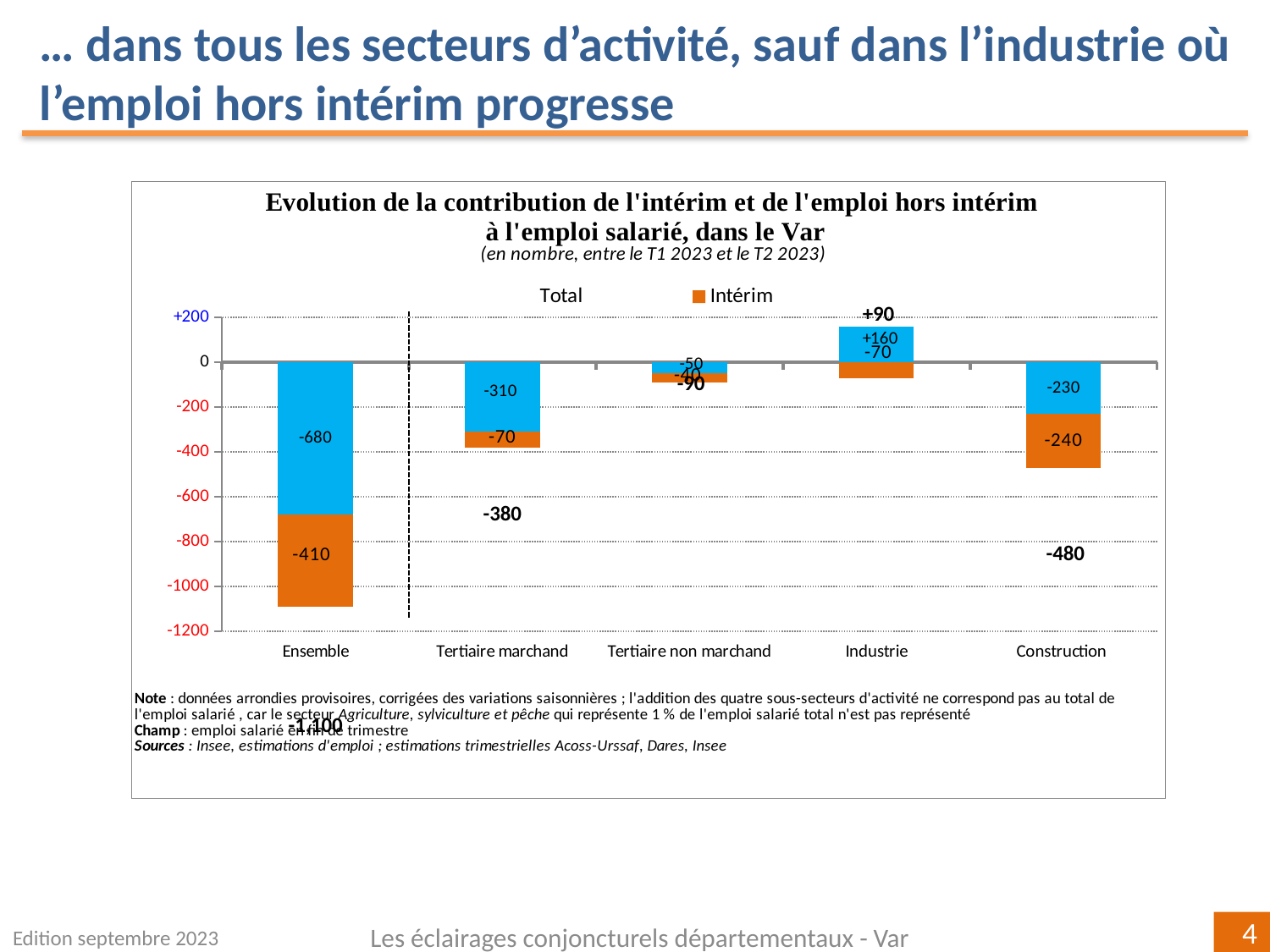
What kind of chart is shown on the slide? bar chart What value is printed on the blue segment for Industrie? +160 Which category has the lowest Total value? Ensemble How many sector categories are shown on the x axis? 5 What is the Total value shown for Tertiaire marchand? -380 What is the Intérim value for Construction? -240 Which category has the highest Total value? Industrie What is the difference between the Intérim values for Construction and Tertiaire marchand? 170 What is the Intérim value for Tertiaire non marchand? -40 Which has the larger decline in Intérim, Construction or Tertiaire marchand? Construction What is the Total value shown for Industrie? +90 What is the Intérim value for Ensemble? -410